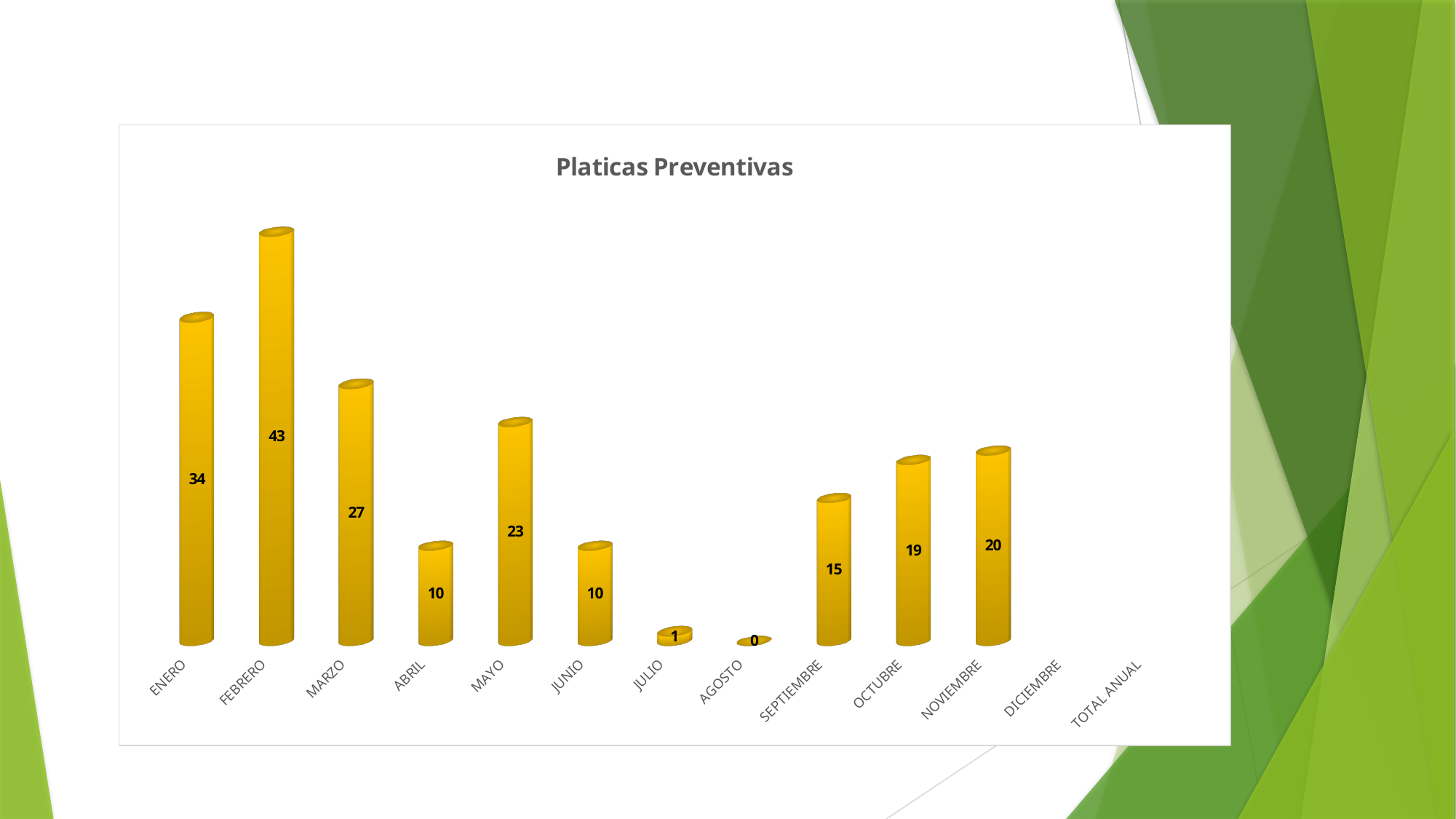
Do the values rise or fall from FEBRERO to AGOSTO? Fall What is the value for SEPTIEMBRE? 15 Which month has the lowest value among the labelled bars? AGOSTO What is the value for MAYO? 23 What is the value for FEBRERO in the Platicas Preventivas chart? 43 What is the difference between the values for FEBRERO and NOVIEMBRE? 23 Which month has the highest value? FEBRERO Which is larger, the value for OCTUBRE or the value for NOVIEMBRE? NOVIEMBRE What is the difference between the values for ENERO and MARZO? 7 What kind of chart is shown on the slide? Bar chart How many category labels are shown on the x axis? 13 What is the title of the chart? Platicas Preventivas